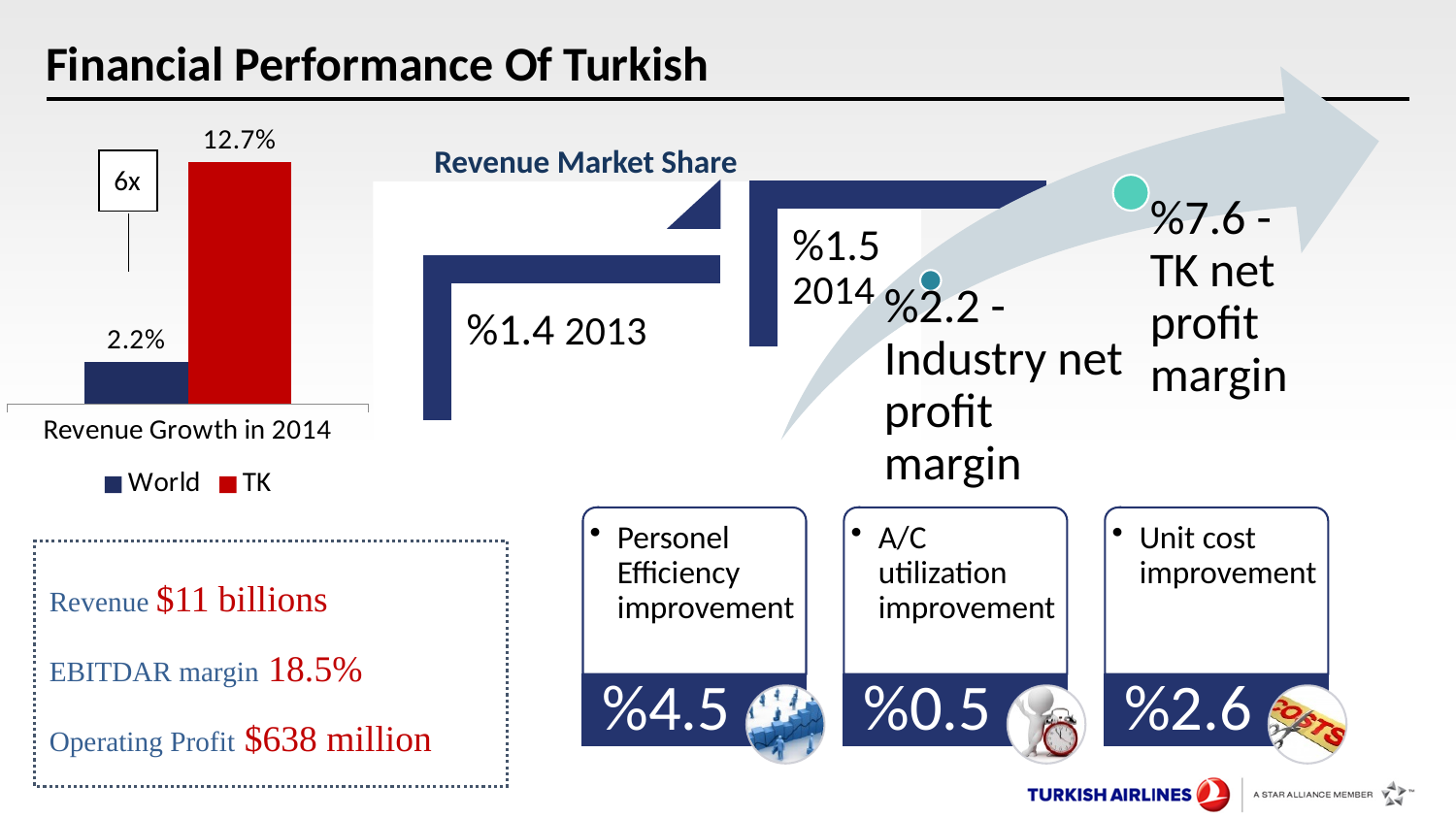
What kind of chart is the Revenue Growth in 2014 chart? bar chart In the Revenue Growth in 2014 chart, which bar is the highest? TK In the Revenue Growth in 2014 chart, which bar is the lowest? World What is the title of the bar chart on the left of the slide? Revenue Growth in 2014 In the Revenue Growth in 2014 chart, which is larger, World or TK? TK How many series does the legend of the Revenue Growth in 2014 chart list? 2 In the Revenue Growth in 2014 chart, what is the value for World? 2.2% How many bars are plotted in the Revenue Growth in 2014 chart? 2 In the Revenue Growth in 2014 chart, what colour is the TK bar? red In the Revenue Growth in 2014 chart, what is the value for TK? 12.7% In the Revenue Growth in 2014 chart, what is the difference between the TK value and the World value? 10.5%